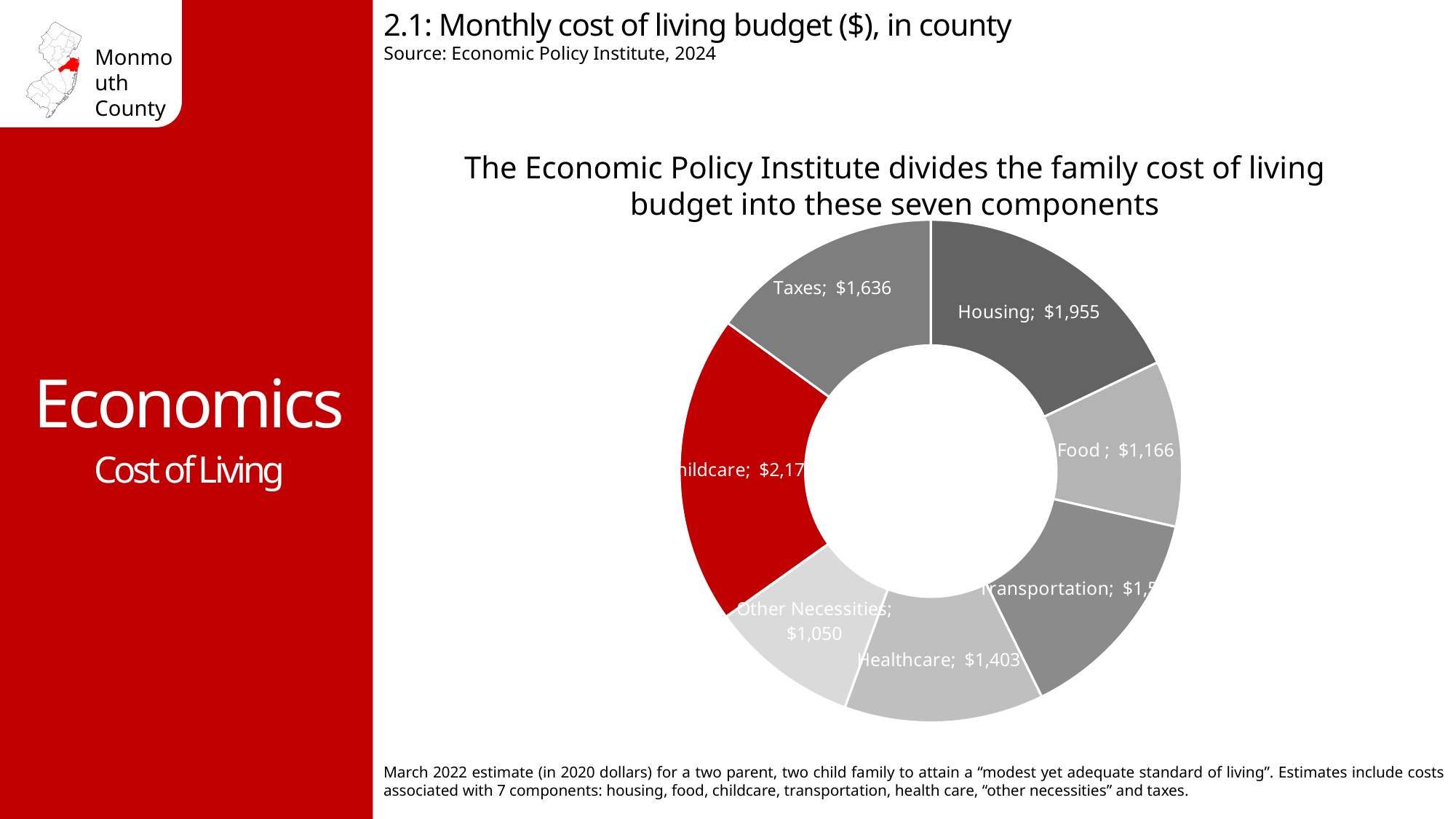
How much more is the Housing cost than the Taxes cost? $319 Which component has the smallest slice in the chart? Other Necessities Which is larger, the Housing cost or the Taxes cost? Housing What is the monthly cost for Healthcare shown on the chart? $1,403 What is the difference between the Healthcare and Food costs? $237 How many components are shown in the chart? 7 What is the monthly cost for Taxes shown on the chart? $1,636 Which component has the largest slice in the chart? Childcare What is the monthly cost for Housing in the donut chart? $1,955 What is the monthly cost for Other Necessities shown on the chart? $1,050 What is the monthly cost for Food shown on the chart? $1,166 What kind of chart is used on the slide? Pie (donut) chart